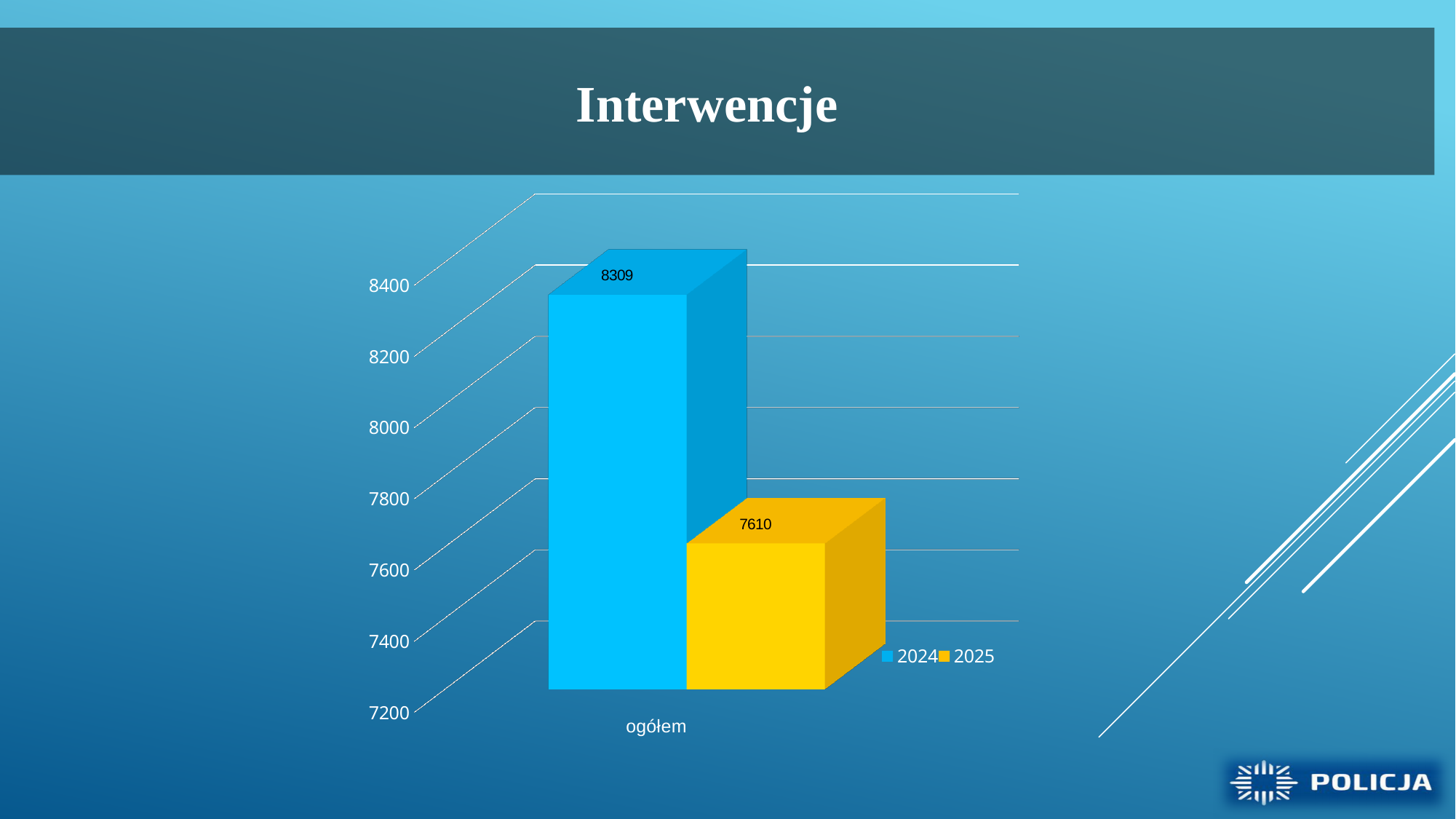
What kind of chart is shown on the slide? bar chart How many series does the legend list? 2 What is the value for 2025 in the ogółem category? 7610 How many categories are shown on the x axis? 1 What is the value for 2024 in the ogółem category? 8309 What is the label of the category on the x axis? ogółem Is the value for 2025 greater or less than 8000? less Which colour represents the 2025 series? yellow What is the difference between the 2024 and 2025 values for ogółem? 699 What is the title of the slide? Interwencje Which series has the higher value for ogółem, 2024 or 2025? 2024 Is the value for 2024 greater or less than 8200? greater